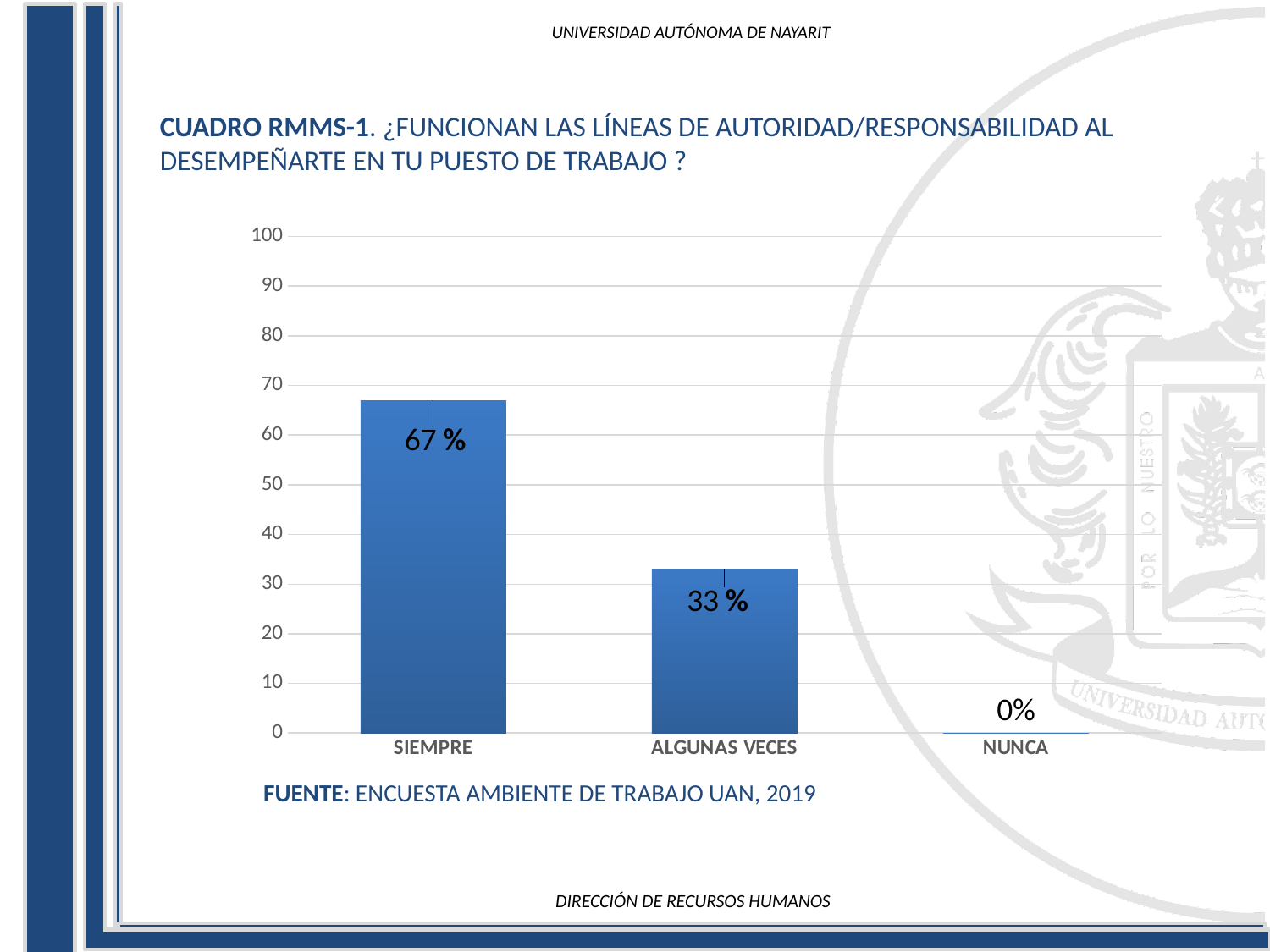
Is the value for ALGUNAS VECES greater or less than 40? less What is the value for ALGUNAS VECES? 33 % What is the value for SIEMPRE? 67 % What is the difference between the values for SIEMPRE and ALGUNAS VECES? 34 % What source is cited below the chart? ENCUESTA AMBIENTE DE TRABAJO UAN, 2019 Which is larger, the value for SIEMPRE or the value for ALGUNAS VECES? SIEMPRE How many categories are shown on the x axis? 3 Which category has the highest value? SIEMPRE Is the value for SIEMPRE greater or less than 60? greater What kind of chart is shown on the slide? bar chart Which category has the lowest value? NUNCA What is the value for NUNCA? 0%